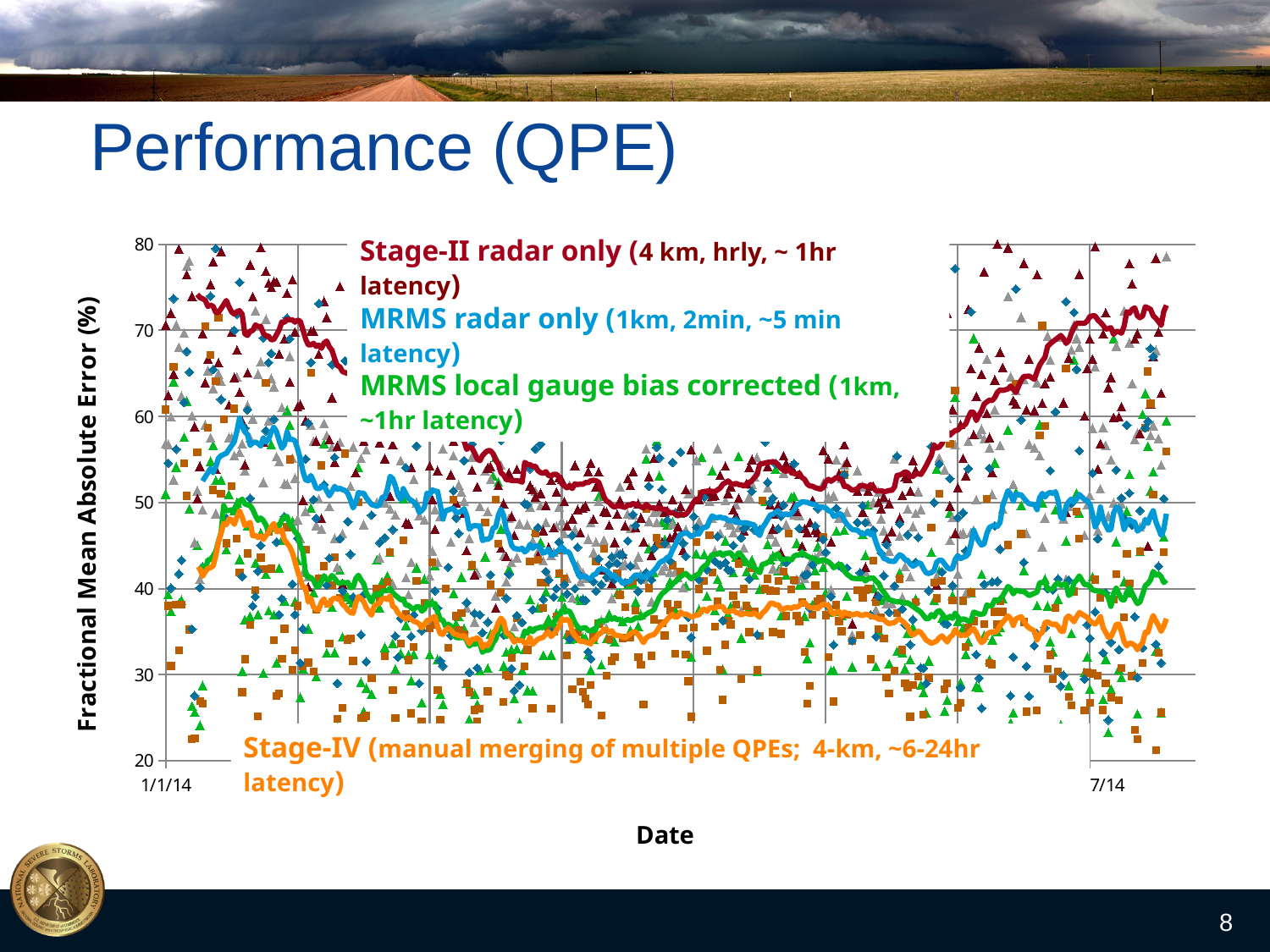
Is the Stage-IV smoothed line near 7/14 greater or less than 40? less What is the title of the slide containing the chart? Performance (QPE) What is the label of the vertical axis? Fractional Mean Absolute Error (%) Is the MRMS radar only smoothed line in the middle of the chart greater or less than 60? less Does the Stage-II radar only line rise or fall over the last portion of the chart leading up to 7/14? rise Near 7/14, which is larger: the MRMS radar only line or the MRMS local gauge bias corrected line? MRMS radar only Which series has the highest Fractional Mean Absolute Error at the right end of the chart (around 7/14)? Stage-II radar only What is the lowest value shown on the vertical axis? 20 Is the Stage-II radar only smoothed line at the start of the chart (1/1/14) greater or less than 60? greater Which series has the lowest Fractional Mean Absolute Error across most of the chart? Stage-IV How many QPE series are labelled on the chart? 4 What kind of chart is shown on the slide? line chart